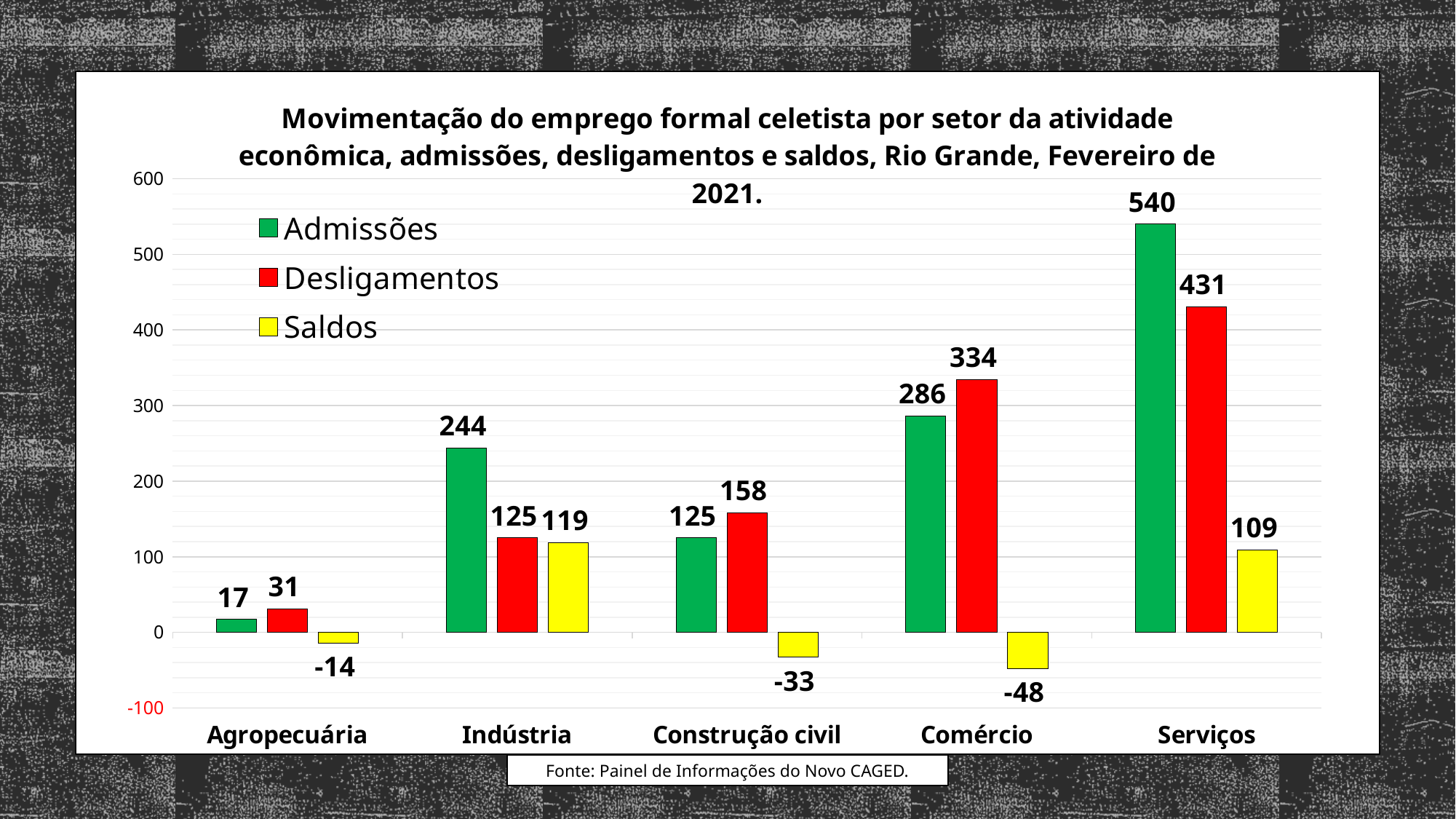
How many sectors are shown on the x axis? 5 What is the Saldos value for Construção civil? -33 What is the Admissões value for Serviços? 540 Which sector has the highest Admissões value? Serviços What colour represents the Saldos series? Yellow What kind of chart is shown on the slide? Bar chart What is the Desligamentos value for Comércio? 334 Which sector has the lowest Saldos value? Comércio What is the difference between Desligamentos and Admissões for Indústria? 119 How many series does the legend list? 3 Which is larger for Construção civil, Admissões or Desligamentos? Desligamentos Is the Desligamentos value for Serviços greater or less than 400? greater